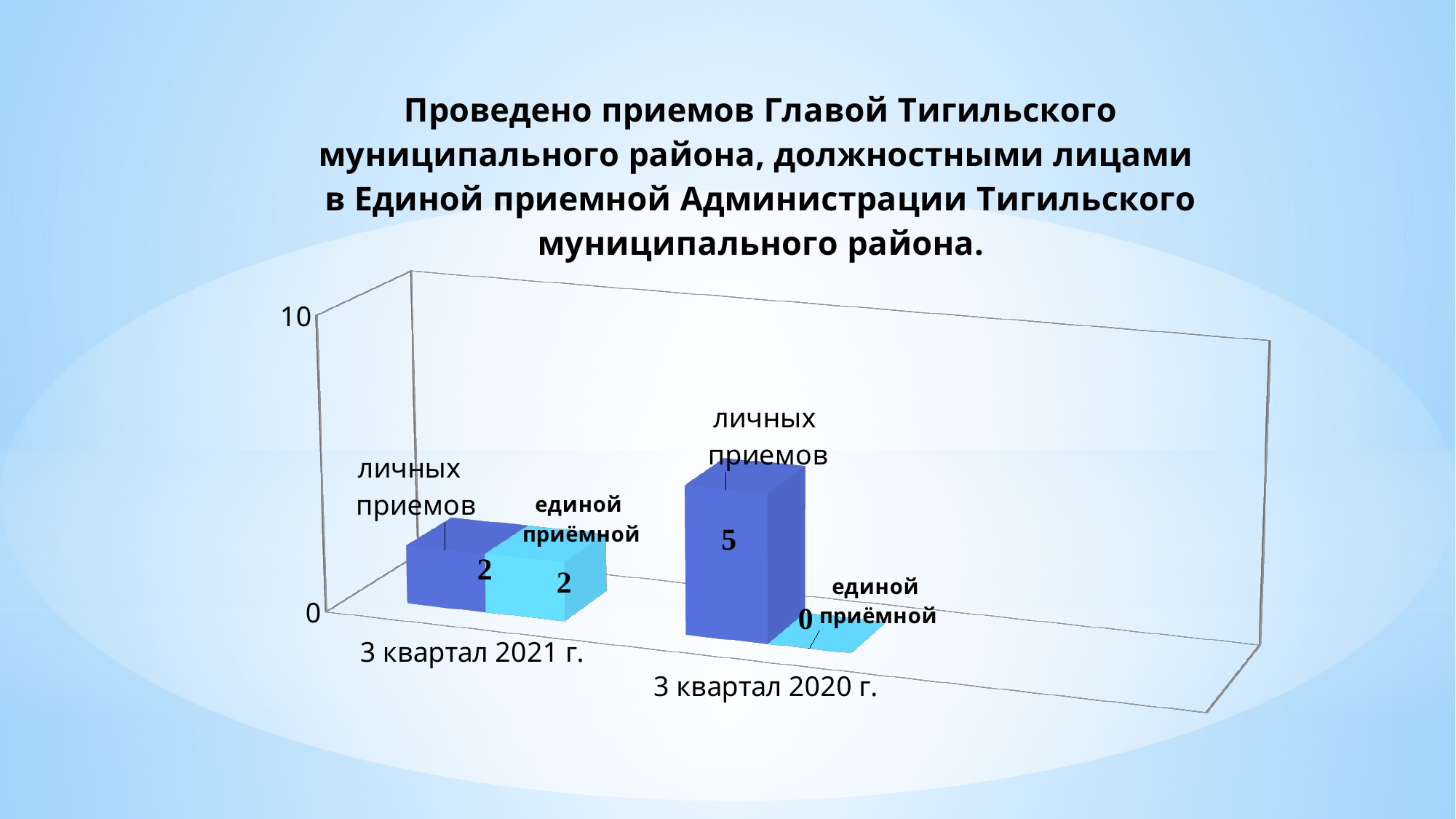
What is the value for единой приёмной in 3 квартал 2021 г.? 2 Which category has the highest value for личных приемов? 3 квартал 2020 г. What type of chart is shown on the slide? bar chart What is the value for единой приёмной in 3 квартал 2020 г.? 0 What is the maximum value shown on the vertical axis of the chart? 10 How many categories are shown on the x axis of the chart? 2 What is the difference between личных приемов in 3 квартал 2020 г. and in 3 квартал 2021 г.? 3 What is the value for личных приемов in 3 квартал 2021 г.? 2 Which is larger: личных приемов in 3 квартал 2020 г. or единой приёмной in 3 квартал 2020 г.? личных приемов in 3 квартал 2020 г. Is the value for личных приемов in 3 квартал 2020 г. greater or less than 10? less What is the value for личных приемов in 3 квартал 2020 г.? 5 Which category has the lowest value for единой приёмной? 3 квартал 2020 г.